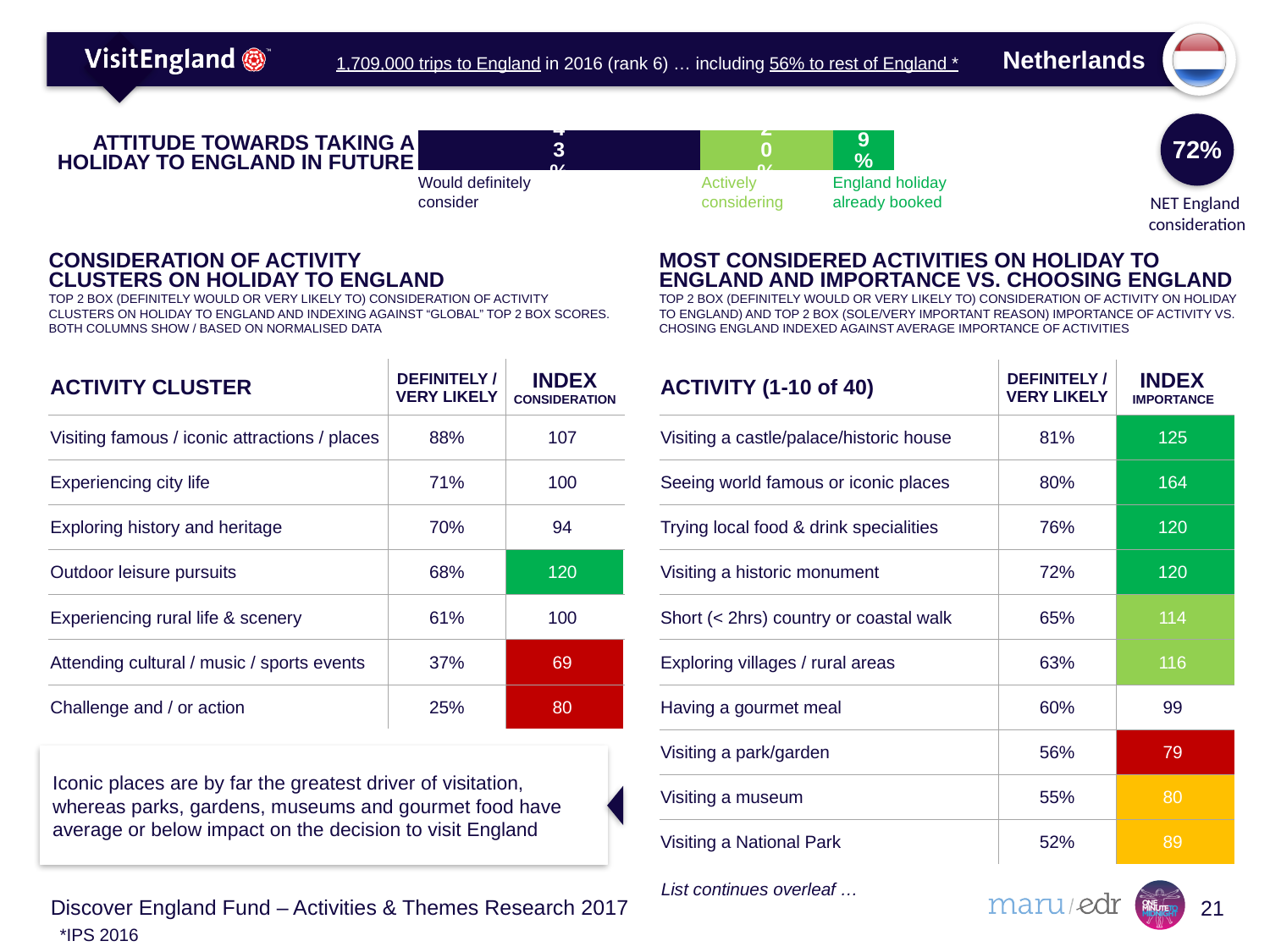
In the 'Attitude towards taking a holiday to England in future' chart, which segment is shown in light green? Actively considering In the 'Attitude towards taking a holiday to England in future' chart, what is the value for 'England holiday already booked'? 9% What kind of chart is used for 'Attitude towards taking a holiday to England in future'? Bar chart In the 'Attitude towards taking a holiday to England in future' chart, which segment is the smallest? England holiday already booked How many segments does the 'Attitude towards taking a holiday to England in future' bar have? 3 What is the NET England consideration figure shown next to the 'Attitude towards taking a holiday to England in future' chart? 72% In the 'Attitude towards taking a holiday to England in future' chart, which segment is the largest? Would definitely consider In the 'Attitude towards taking a holiday to England in future' chart, which is larger: 'Would definitely consider' or 'Actively considering'? Would definitely consider In the 'Attitude towards taking a holiday to England in future' chart, what colour is the 'Would definitely consider' segment? Dark navy blue